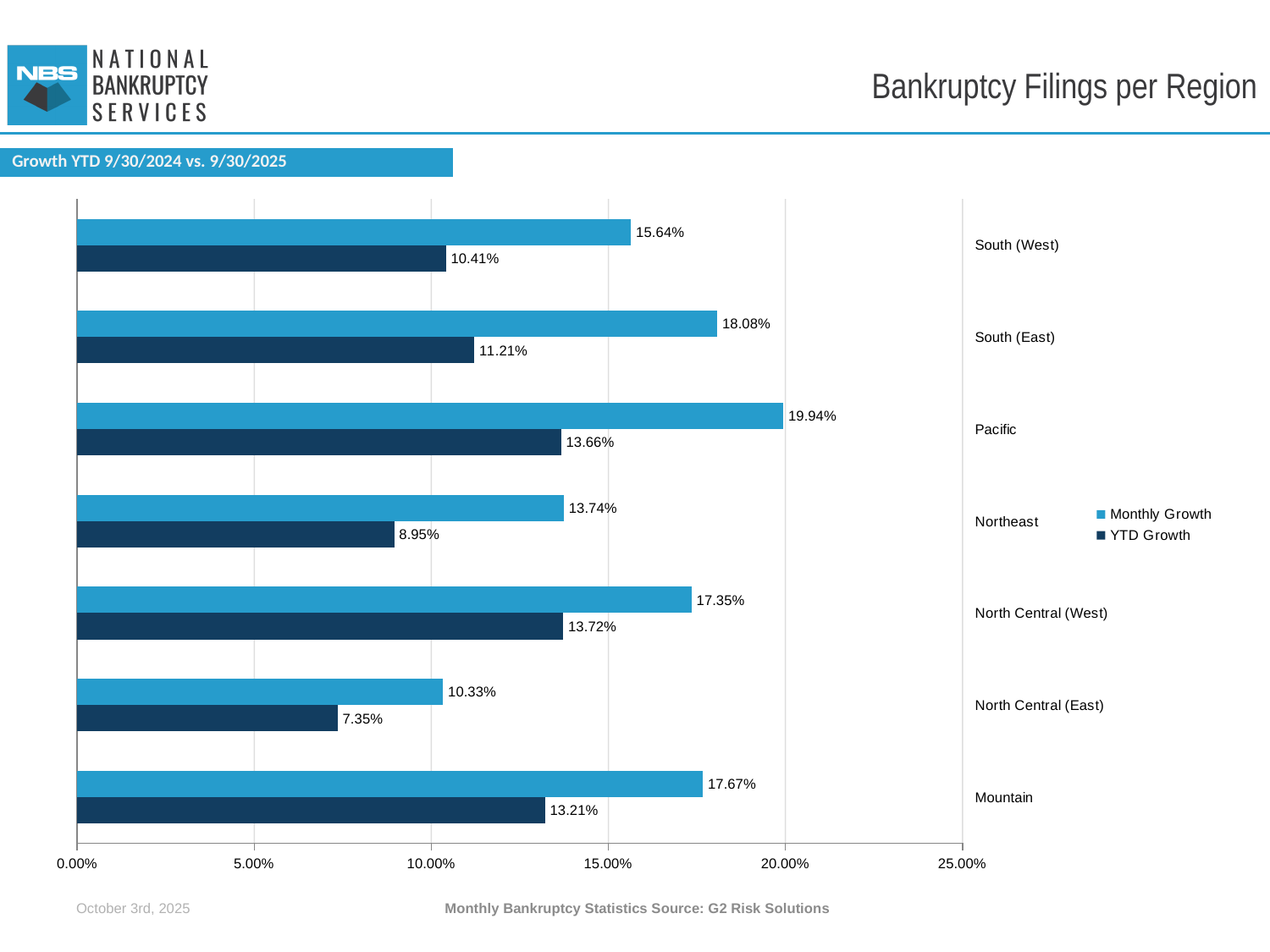
What is the Monthly Growth value for Pacific? 19.94% Which region has the highest Monthly Growth? Pacific How many regions are shown in the chart? 7 Which is larger, the Monthly Growth for South (West) or for North Central (West)? North Central (West) What is the YTD Growth value for North Central (East)? 7.35% Which region has the lowest Monthly Growth? North Central (East) What is the difference between Monthly Growth and YTD Growth for Mountain? 4.46% How many series does the legend list? 2 What is the difference between Monthly Growth and YTD Growth for Pacific? 6.28% What is the YTD Growth value for South (East)? 11.21% Is the Monthly Growth value for South (East) greater or less than 15.00%? greater Which region has the lowest YTD Growth? North Central (East)